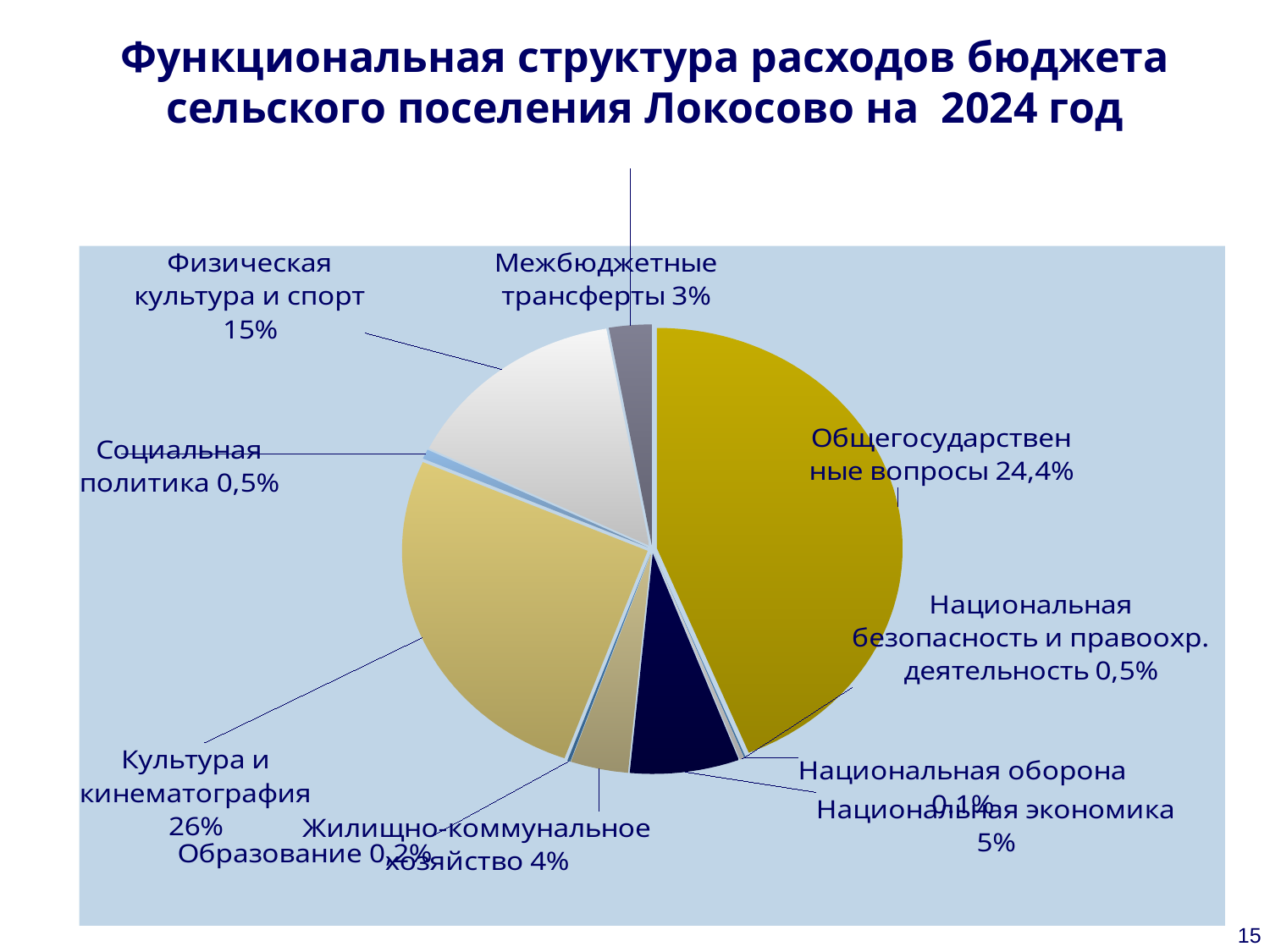
How many categories are shown in the pie chart? 10 What share of the budget expenditure goes to Культура и кинематография? 26% What share is shown for Общегосударственные вопросы? 24,4% Which category has the smallest share of the pie? Национальная оборона What share is shown for Жилищно-коммунальное хозяйство? 4% Which category has the largest share of the pie? Общегосударственные вопросы Which is larger: the share for Национальная экономика or the share for Жилищно-коммунальное хозяйство? Национальная экономика What is the difference in percentage points between Культура и кинематография and Физическая культура и спорт? 11 Which year does the slide title say the budget expenditure structure refers to? 2024 What percentage is labelled for Физическая культура и спорт? 15% What type of chart is shown on the slide? Pie chart What percentage is given for Межбюджетные трансферты? 3%